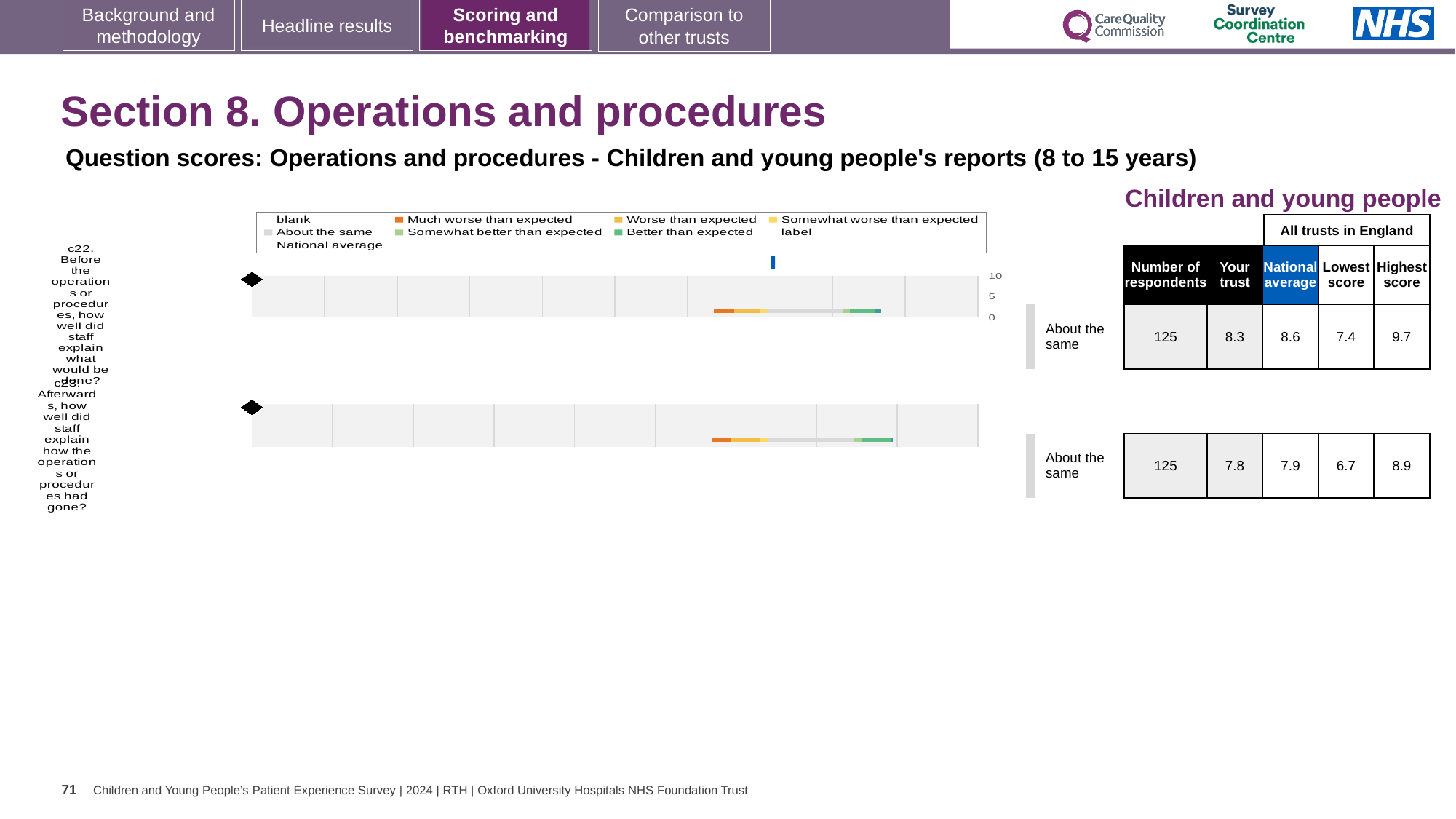
What kind of chart is used to show the question scores for c22 and c23? bar chart What is the lowest score among all trusts in England for c23? 6.7 How many questions (c22 and c23) are plotted on the slide? 2 What is the difference between the highest and lowest scores for c23? 2.2 Which legend entry is shown in orange? Much worse than expected Which is larger for c22, the 'Your trust' score or the national average? National average What is the 'Your trust' score for c22 (Before the operations or procedures, how well did staff explain what would be done?)? 8.3 What is the national average score for c23 (Afterwards, how well did staff explain how the operations or procedures had gone?)? 7.9 What benchmark category is shown for both c22 and c23? About the same What is the difference between the national average and the 'Your trust' score for c22? 0.3 What is the highest score among all trusts in England for c22? 9.7 How many respondents answered c22? 125